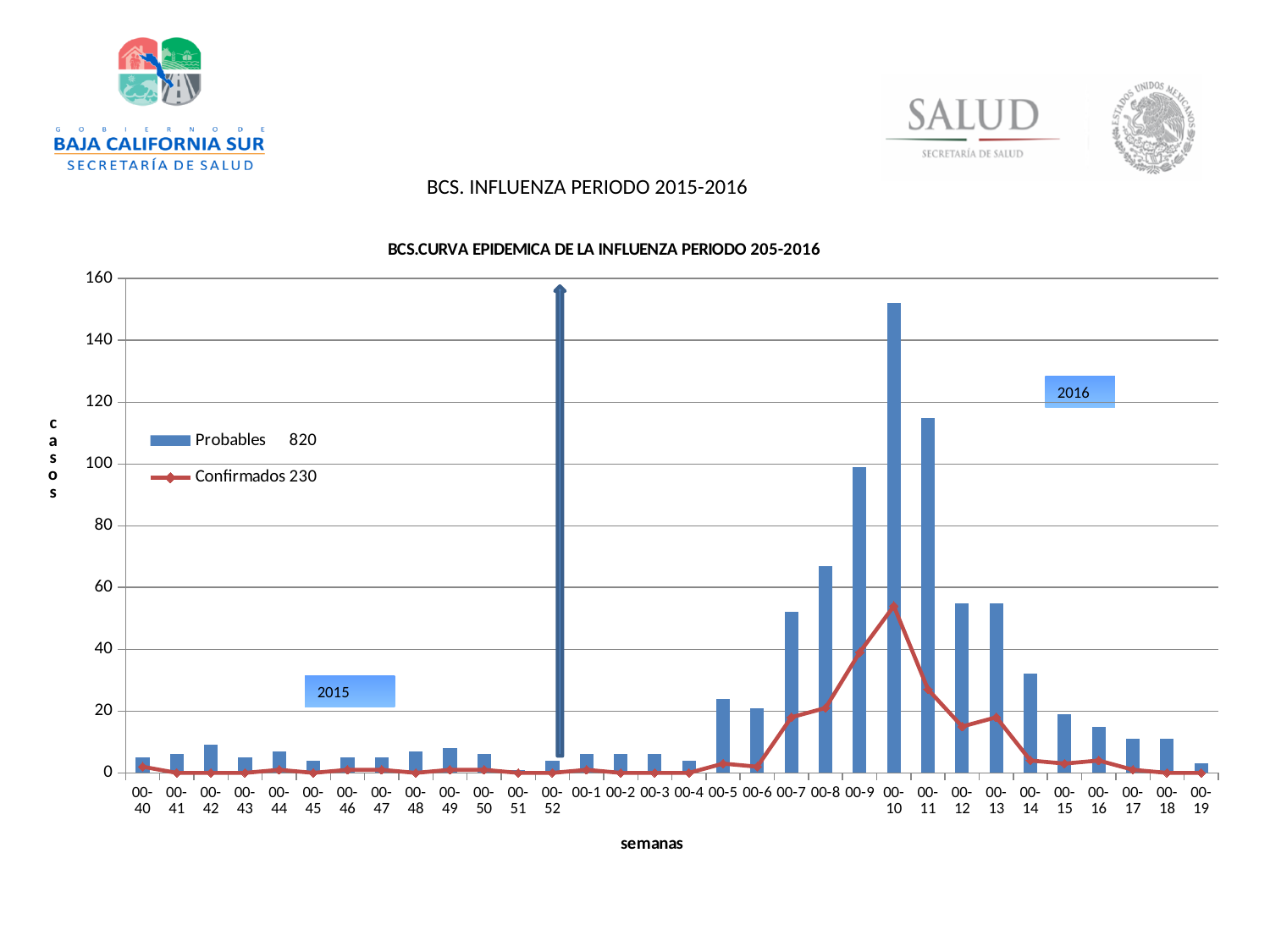
How many weeks (categories) are plotted along the x axis? 32 Which week has the larger Probables bar, 00-10 or 00-11? 00-10 Is the Probables value for week 00-11 greater or less than 100? greater In which week is the Probables bar highest? 00-10 What kind of chart is shown on the slide? Bar chart with a line series Is the Probables value for week 00-14 greater or less than 40? less Do the Probables values rise or fall from week 00-10 to week 00-19? fall Is the Confirmados value for week 00-10 greater or less than 40? greater What total is shown next to the Confirmados entry in the legend? 230 In which week does the Confirmados line reach its peak? 00-10 How many series does the chart legend list? 2